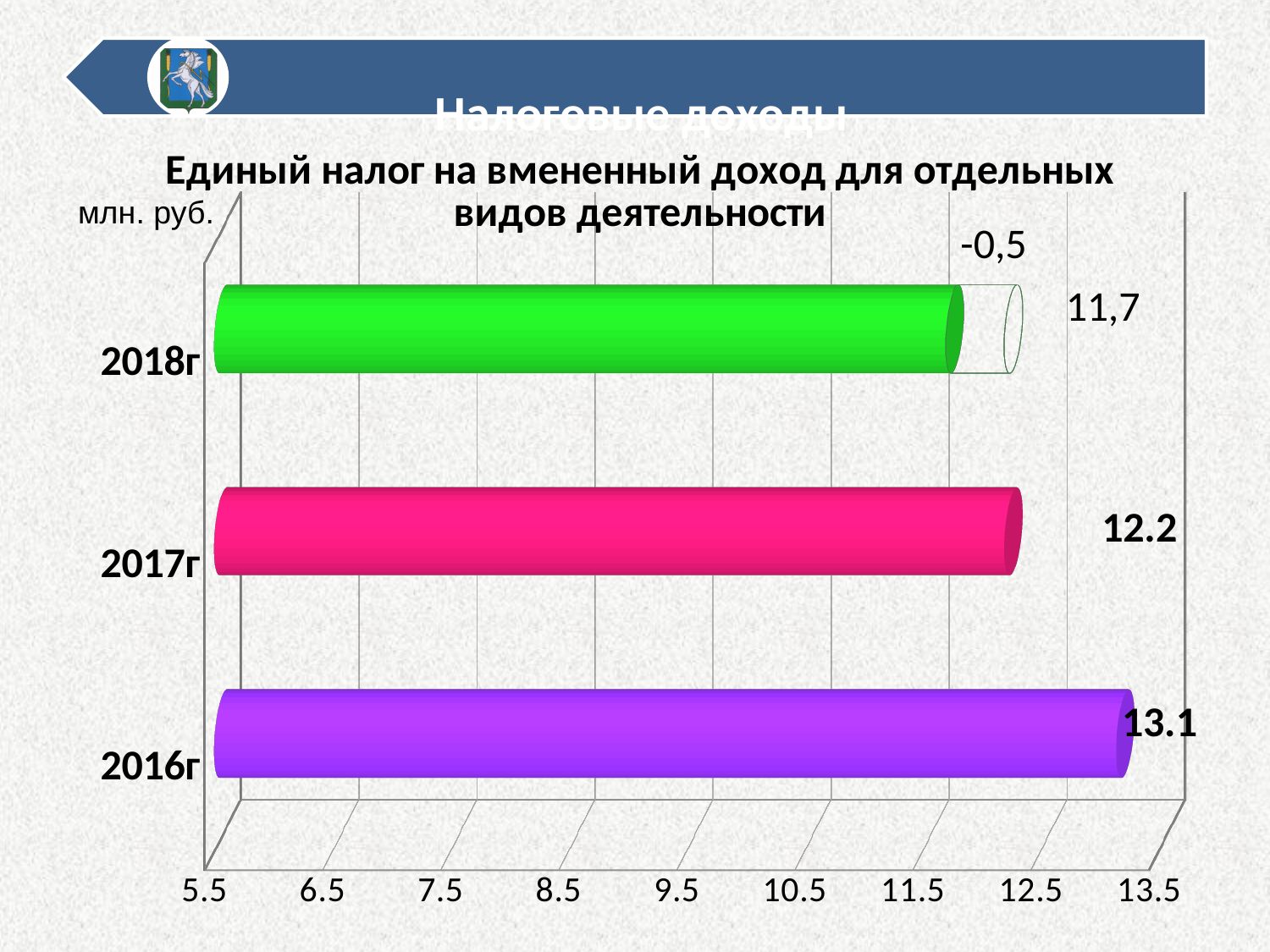
What is the difference between the values for 2017г and 2018г? 0.5 Which year has the highest value? 2016г How many years are shown in the chart? 3 What is the value for 2016г? 13.1 What kind of chart is shown on the slide? Bar chart What is the value for 2018г? 11,7 Which year has the lowest value? 2018г What is the value for 2017г? 12.2 What is the difference between the values for 2016г and 2017г? 0.9 Which is larger, the value for 2017г or the value for 2018г? 2017г What unit of measurement is indicated for the chart? млн. руб. Do the values rise or fall from 2016г to 2018г? Fall